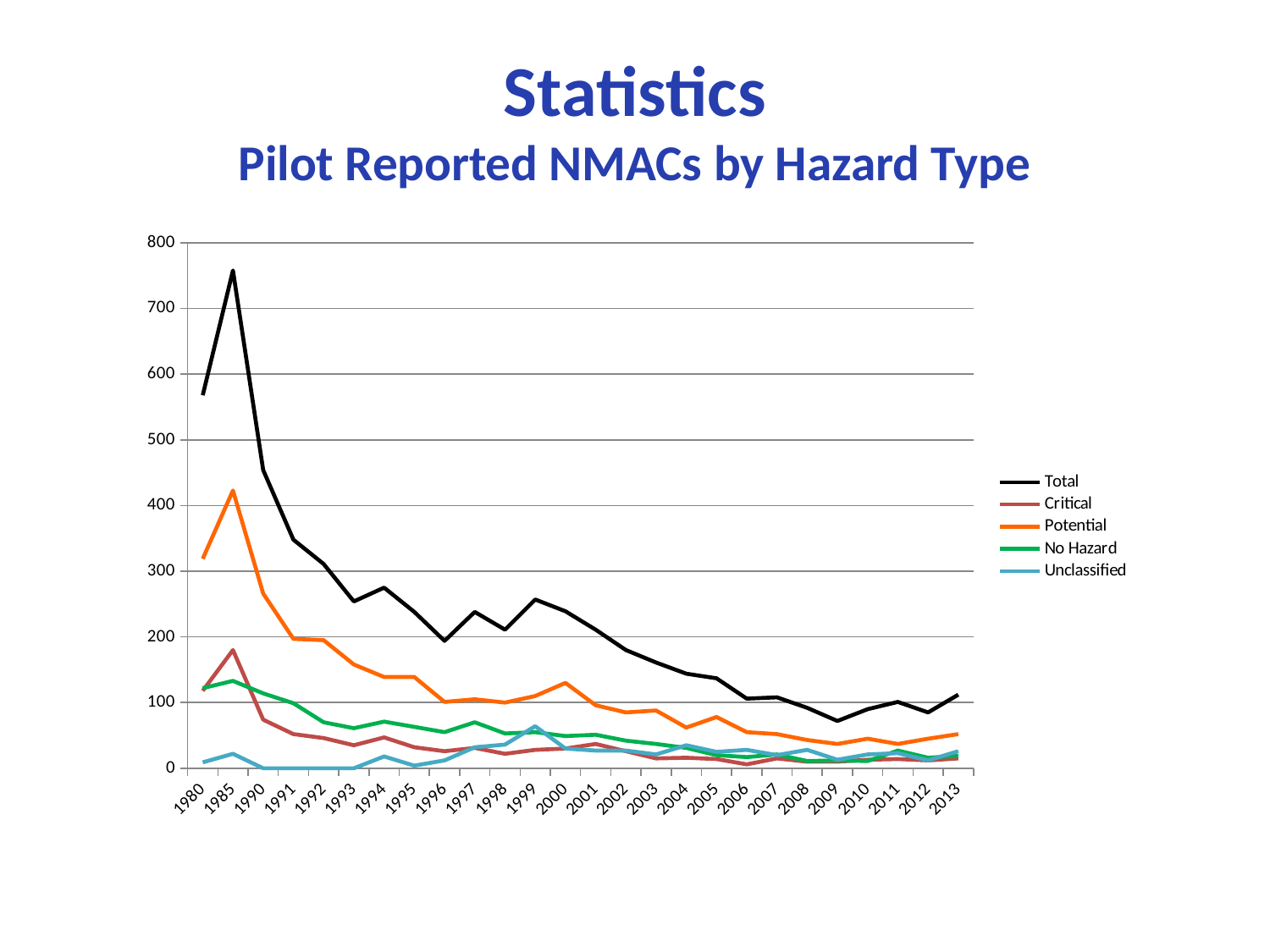
How many series does the legend list? 5 Is the value for Total in 1980 greater or less than 600? less Is the value for Total in 2009 greater or less than 100? less Does the Total series generally rise or fall from 1985 to 2013? fall Is the value for Potential in 1985 greater or less than 400? greater What kind of chart is shown on the slide? line chart How many years are shown along the x axis? 26 In which year does the Total series reach its highest value? 1985 Which series has the lowest value in 1990? Unclassified What colour is the line for the Potential series? orange Which is larger in 1990, the value for Potential or the value for No Hazard? Potential